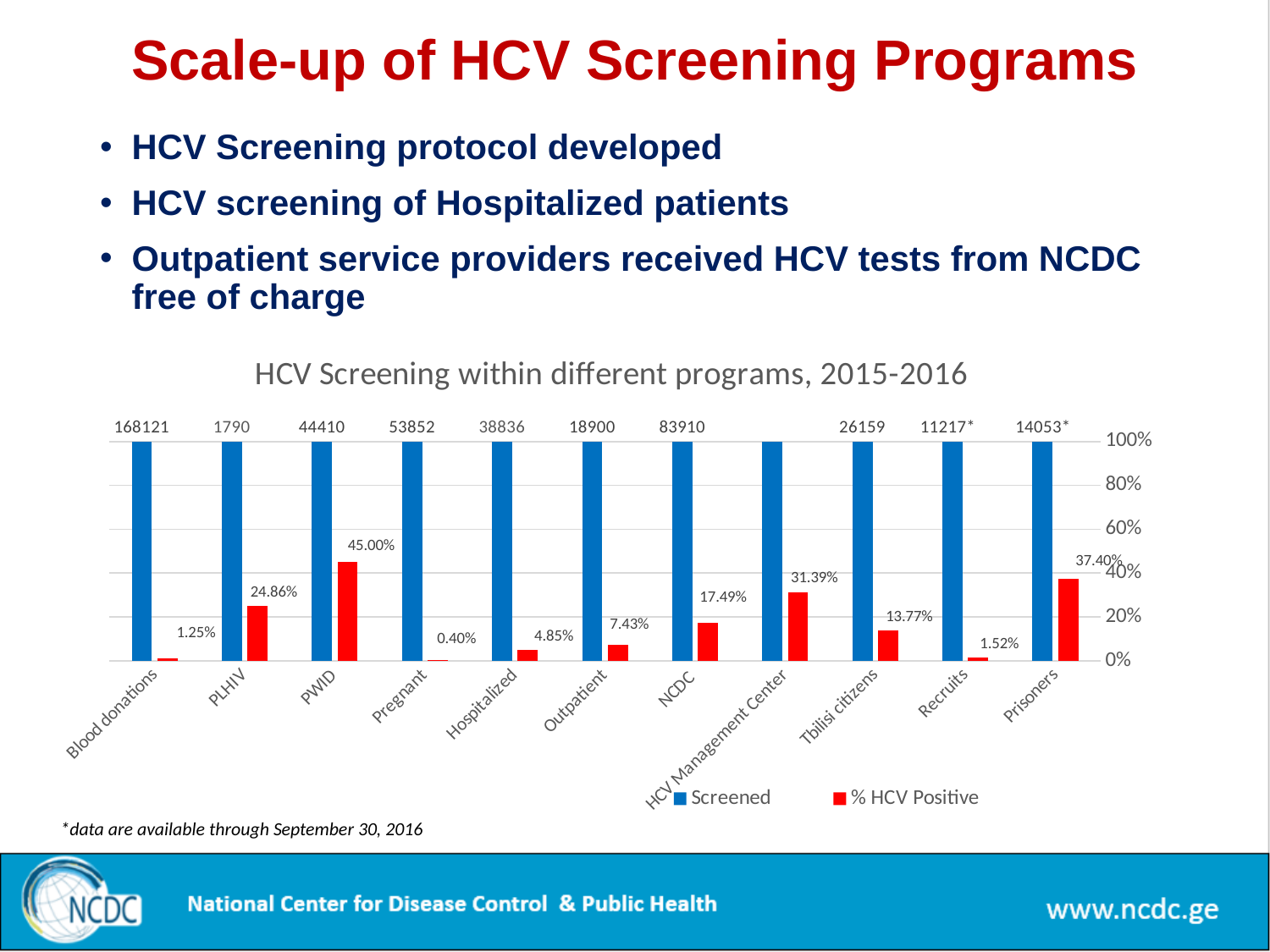
How many series does the legend list? 2 How many people were screened in the Blood donations program? 168121 How many programs (categories) are shown on the x axis? 11 What is the % HCV Positive value for Prisoners? 37.40% What kind of chart is shown on the slide? Bar chart What is the difference in % HCV Positive between PLHIV and Hospitalized? 20.01% Which program has the highest % HCV Positive? PWID Which has a higher % HCV Positive, HCV Management Center or NCDC? HCV Management Center What is the % HCV Positive value for PWID? 45.00% Which program has the lowest % HCV Positive? Pregnant What is the title of the chart? HCV Screening within different programs, 2015-2016 What is the Screened value for Tbilisi citizens? 26159